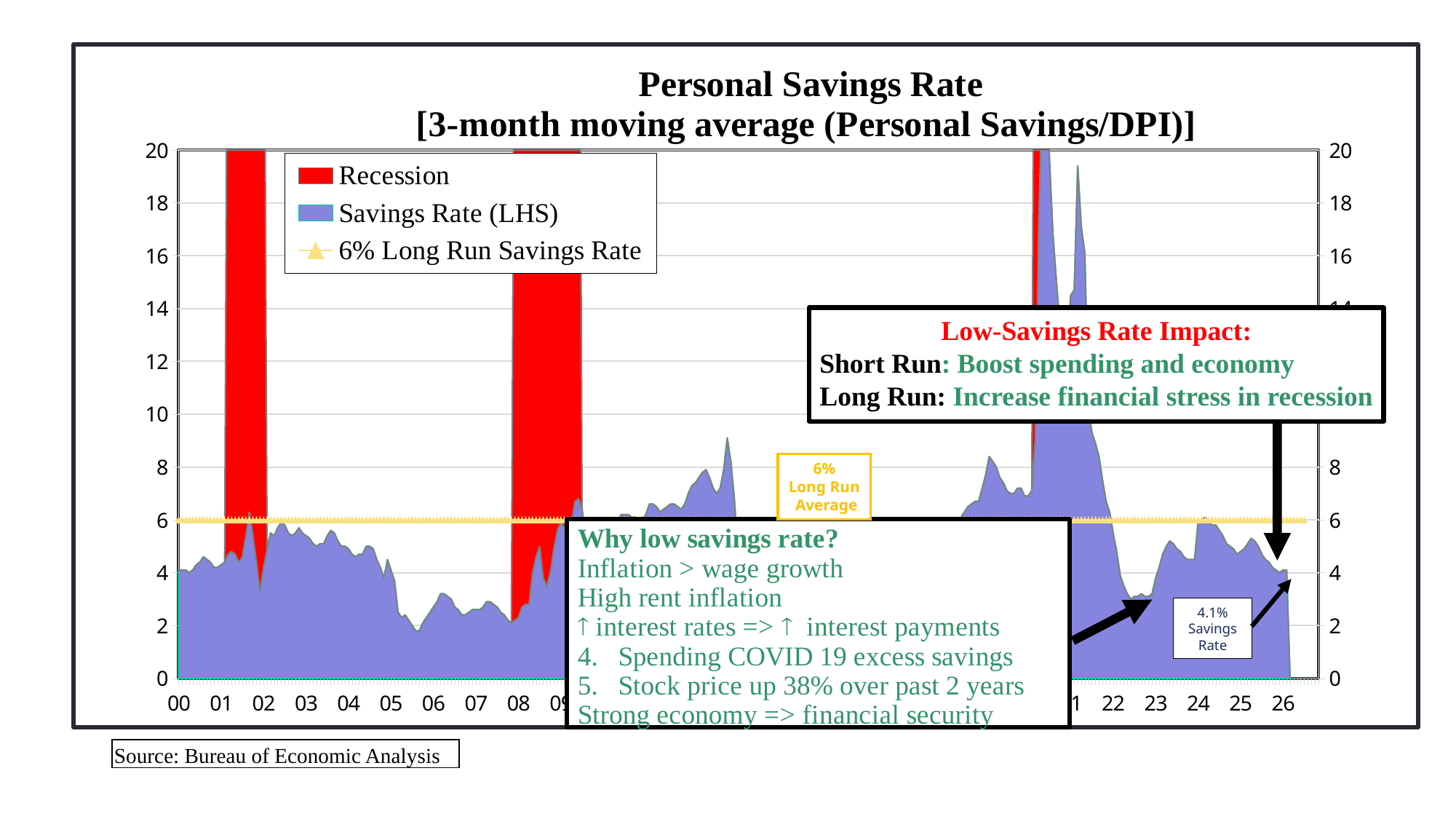
Is the peak savings rate in 2020 greater or less than 18? greater Does the savings rate rise or fall from 2020 to 2022? Fall What is the most recent savings rate value labelled on the chart? 4.1% Which is larger, the savings rate in 2019 or the savings rate in 2005? 2019 How many recession periods are shaded on the chart? 3 Is the savings rate in 2005 greater or less than 4? less In which year does the savings rate reach its highest peak? 2020 What is the long run average savings rate shown by the horizontal line? 6% Is the savings rate in 2019 greater or less than 6? greater What kind of chart is used to show the savings rate? Area chart What is the title of the chart? Personal Savings Rate [3-month moving average (Personal Savings/DPI)] How many entries does the chart legend list? 3